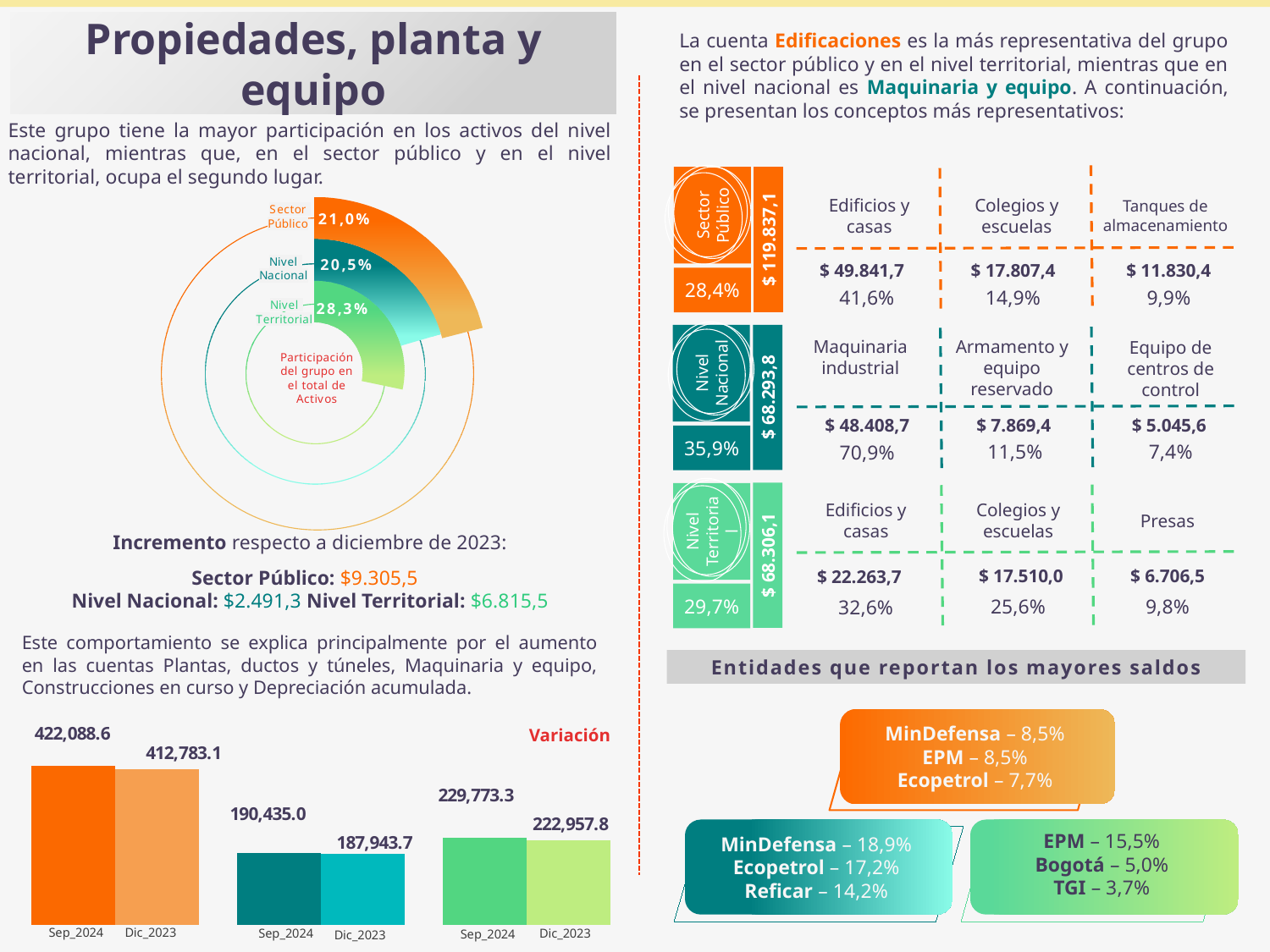
In the radial chart at the top left, what is the difference in percentage points between Nivel Territorial and Sector Público? 7,3 In the radial chart at the top left, what is the value shown for Sector Público? 21,0% In the radial chart at the top left, what is the value shown for Nivel Territorial? 28,3% In the radial chart at the top left, which category has the highest participation? Nivel Territorial In the bar chart at the bottom left, what is the Dic_2023 value of the middle (teal) group? 187,943.7 In the radial chart at the top left, which category has the lowest participation? Nivel Nacional In the radial chart at the top left, how many categories are plotted? 3 In the bar chart at the bottom left, what is the difference between the Sep_2024 and Dic_2023 values of the leftmost (orange) group? 9,305.5 In the bar chart at the bottom left, which is larger in the rightmost (green) group: Sep_2024 or Dic_2023? Sep_2024 In the bar chart at the bottom left, what is the Sep_2024 value of the rightmost (green) group? 229,773.3 In the bar chart at the bottom left, what is the Sep_2024 value of the leftmost (orange) group? 422,088.6 What kind of chart is shown at the bottom left of the slide? Bar chart